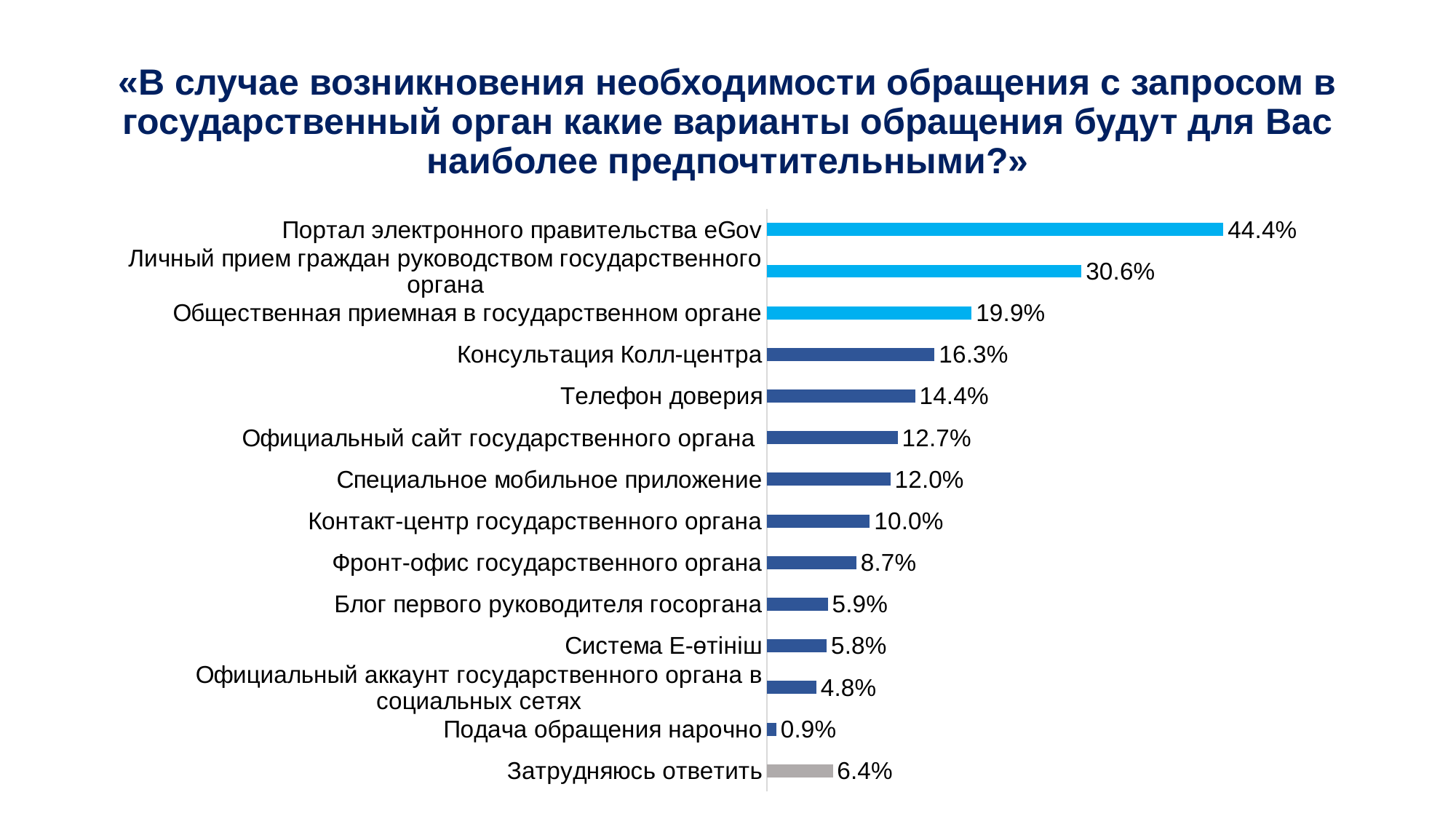
What is the difference between «Портал электронного правительства eGov» and «Личный прием граждан руководством государственного органа»? 13.8% What is the value for «Подача обращения нарочно»? 0.9% What kind of chart is shown on the slide? Bar chart Which category has the lowest value? Подача обращения нарочно Which category has the highest value? Портал электронного правительства eGov What is the difference between «Контакт-центр государственного органа» and «Фронт-офис государственного органа»? 1.3% What is the value for «Телефон доверия»? 14.4% How many categories are shown in the chart? 14 What is the value for «Затрудняюсь ответить»? 6.4% Which is larger: «Консультация Колл-центра» or «Официальный сайт государственного органа»? Консультация Колл-центра What is the value for «Портал электронного правительства eGov»? 44.4% What colour is the bar for «Затрудняюсь ответить»? Grey